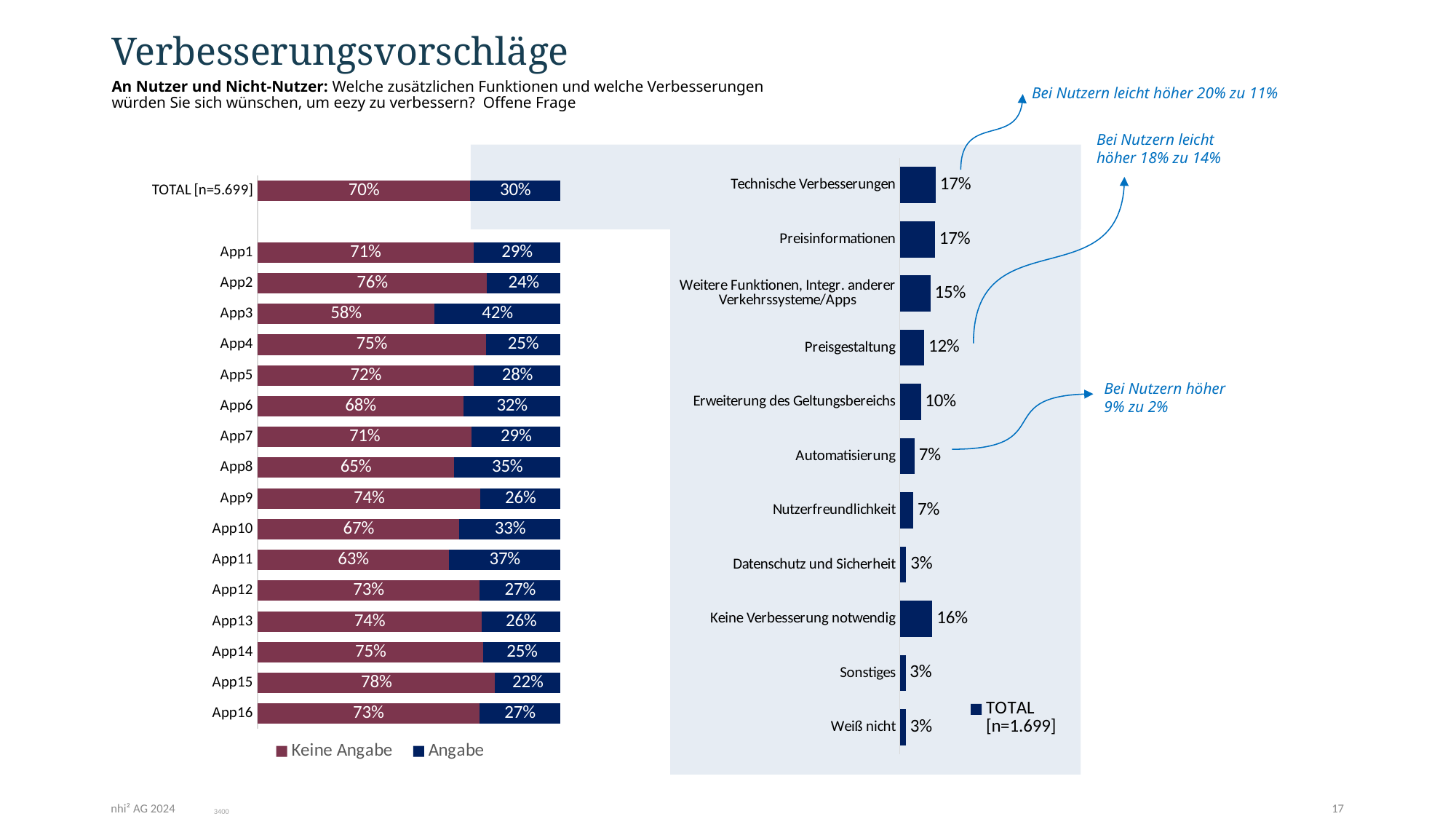
In the left stacked bar chart, what is the total of the TOTAL [n=5.699] bar? 100% In the left stacked bar chart, what is the difference between the 'Keine Angabe' values of App2 and App11? 13% In the left stacked bar chart, how many series does the legend list? 2 In the right bar chart, what is the value for 'Keine Verbesserung notwendig'? 16% In the left stacked bar chart, what is the 'Angabe' value for App3? 42% In the right bar chart, which is larger: 'Preisgestaltung' or 'Erweiterung des Geltungsbereichs'? Preisgestaltung In the right bar chart, what is the difference between 'Technische Verbesserungen' and 'Automatisierung'? 10% What type of chart is shown on the right side of the slide? Bar chart In the left stacked bar chart, what is the 'Keine Angabe' value for App15? 78% In the left stacked bar chart, which app has the highest 'Angabe' share? App3 In the right bar chart, how many categories are shown? 11 In the left stacked bar chart, which app has the lowest 'Angabe' share? App15